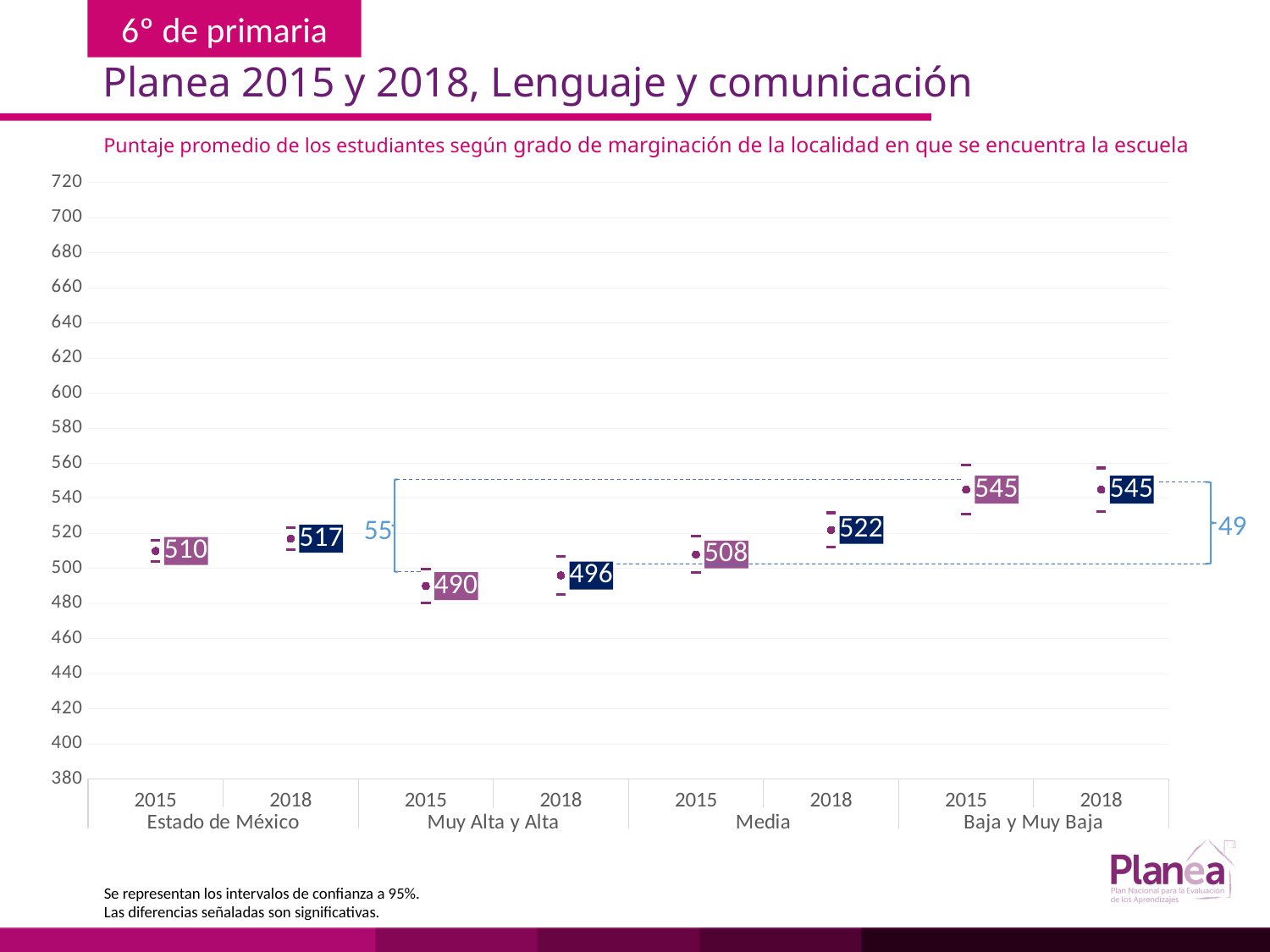
What is the 2015 average score for Estado de México? 510 What is the subtitle describing what the chart plots? Puntaje promedio de los estudiantes según grado de marginación de la localidad en que se encuentra la escuela What is the 2018 average score for Estado de México? 517 What is the difference between the 2018 and 2015 average scores for the Media group? 14 What is the 2018 average score for the Media marginación group? 522 What is the 2018 average score for the Baja y Muy Baja marginación group? 545 Which group and year has the lowest average score on the chart? Muy Alta y Alta, 2015 What is the difference between the 2015 scores of the Baja y Muy Baja group and the Muy Alta y Alta group, as annotated on the chart? 55 How many marginación groups are shown along the x axis? 4 Is the 2015 value for the Baja y Muy Baja group greater or less than 540? greater Which is larger, the 2018 score for Muy Alta y Alta or the 2018 score for Estado de México? Estado de México (517) What is the 2015 average score for the Muy Alta y Alta marginación group? 490